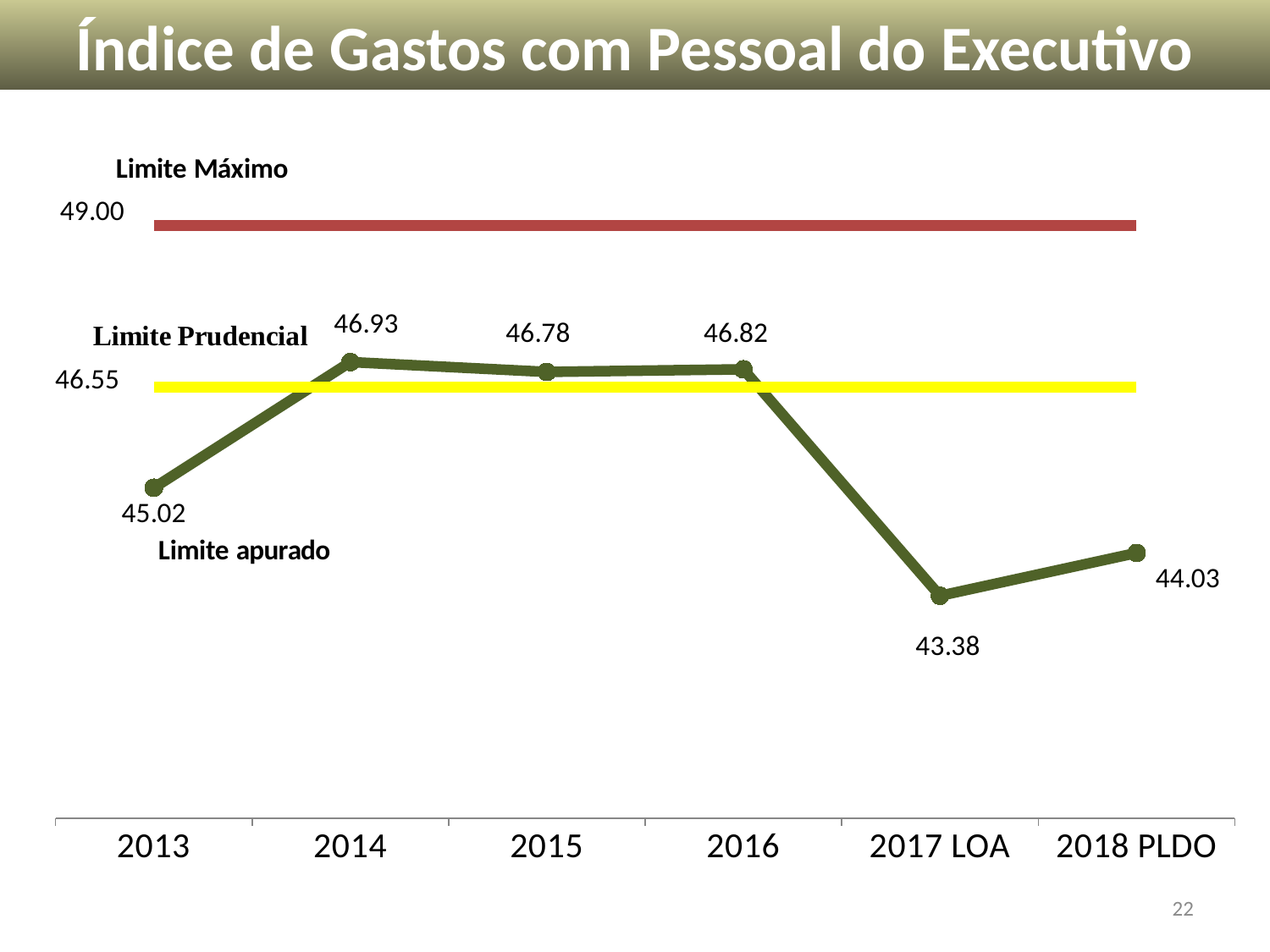
What value is shown for the Limite Máximo line? 49.00 What is the Limite apurado value for 2017 LOA? 43.38 What is the Limite apurado value for 2018 PLDO? 44.03 What is the difference between the Limite apurado values for 2014 and 2017 LOA? 3.55 Which is larger, the Limite apurado value for 2013 or for 2018 PLDO? 2013 Which year has the lowest Limite apurado value? 2017 LOA How many years are shown on the x axis? 6 What kind of chart is shown on the slide? Line chart Does the Limite apurado value rise or fall from 2016 to 2017 LOA? Fall Which year has the highest Limite apurado value? 2014 What is the Limite apurado value for 2014? 46.93 What value is shown for the Limite Prudencial line? 46.55